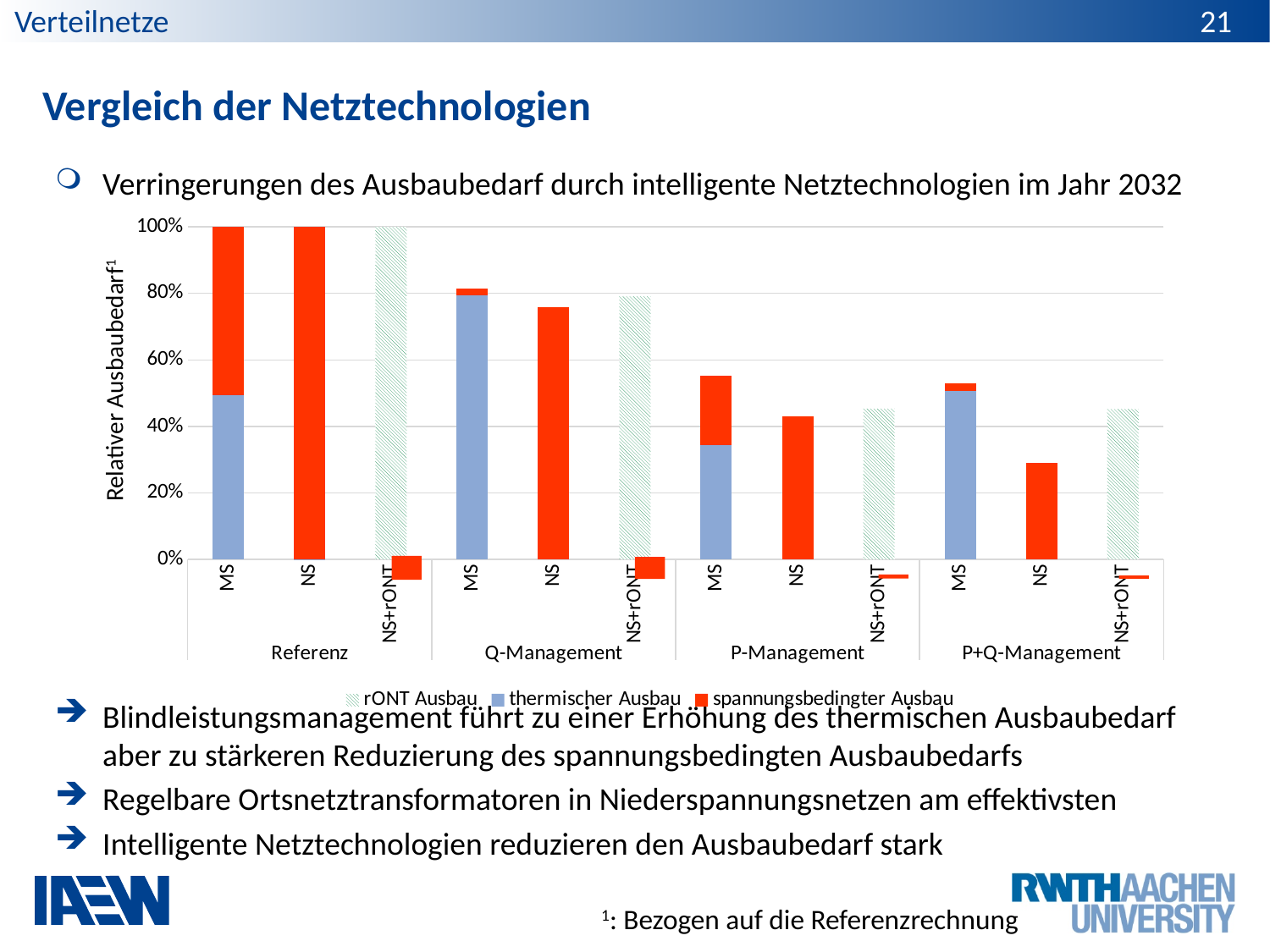
Which is larger: the NS bar in the Referenz group or the NS bar in the P+Q-Management group? Referenz What kind of chart is shown on the slide? stacked bar chart Is the value for the NS bar in the Q-Management group greater or less than 80%? less How many series does the chart legend list? 3 What is the total relative Ausbaubedarf for the MS bar in the Referenz group? 100% How many management groups (category groups) are shown along the x axis of the chart? 4 What are the three series named in the chart legend? rONT Ausbau, thermischer Ausbau, spannungsbedingter Ausbau Is the total value for the MS bar in the P-Management group greater or less than 40%? greater Is the value for the NS bar in the P+Q-Management group greater or less than 40%? less Do the NS bars rise or fall from the Referenz group to the P+Q-Management group? fall Which group has the lowest NS bar? P+Q-Management What is the total relative Ausbaubedarf for the NS bar in the Referenz group? 100%